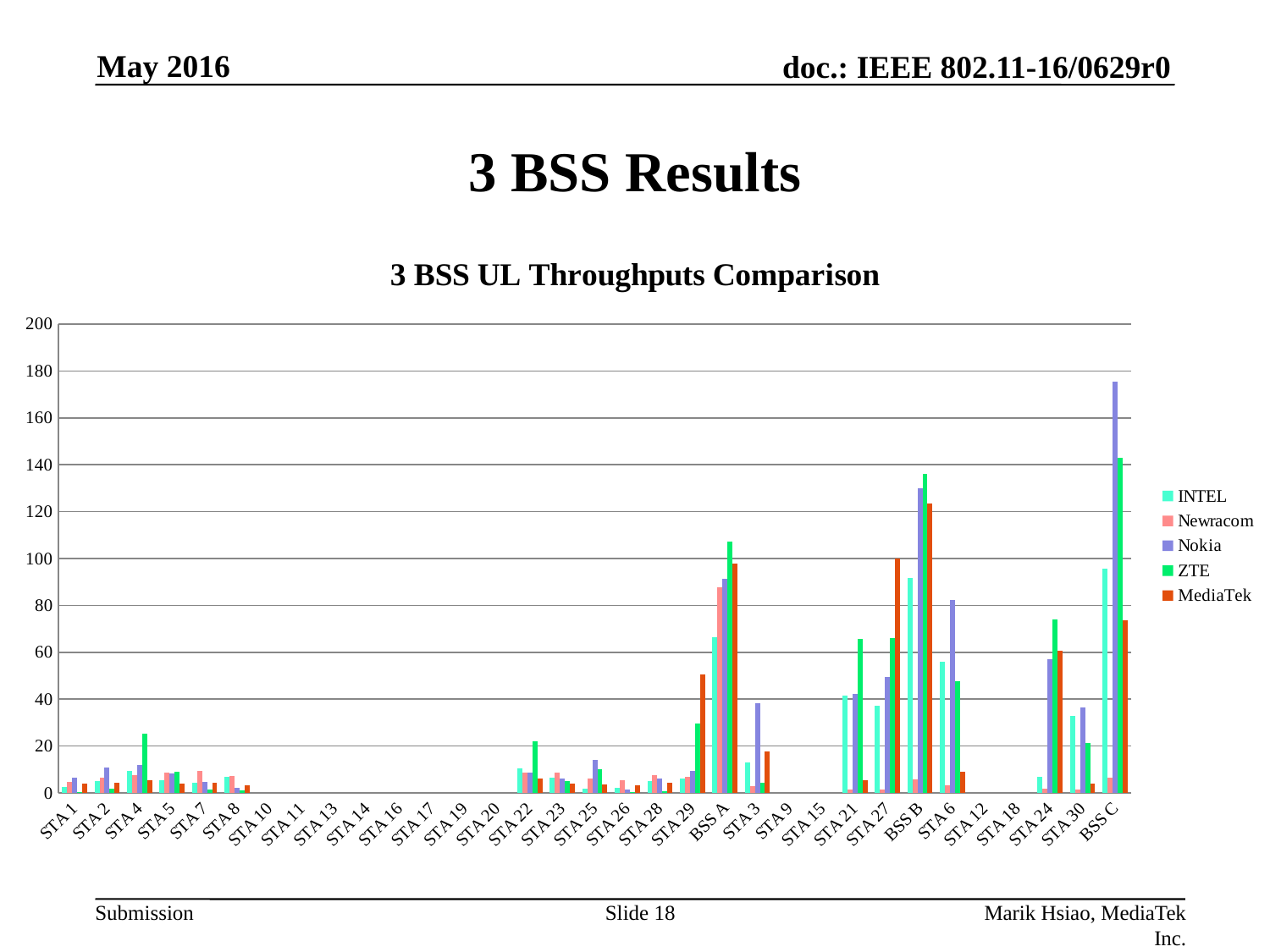
Which category has the tallest bar in the whole chart? BSS C What is the highest value shown on the vertical axis? 200 Which series has the tallest bar for BSS C? Nokia Which series has the tallest bar for BSS B? ZTE Which is larger: the INTEL value for BSS B or the INTEL value for STA 6? BSS B Is the Nokia value for STA 6 greater or less than 60? greater What kind of chart is shown on the slide? bar chart Is the ZTE value for BSS B greater or less than 120? greater Which series is listed last in the legend? MediaTek Is the Nokia value for BSS C greater or less than 160? greater What is the title of the chart? 3 BSS UL Throughputs Comparison How many series does the legend list? 5